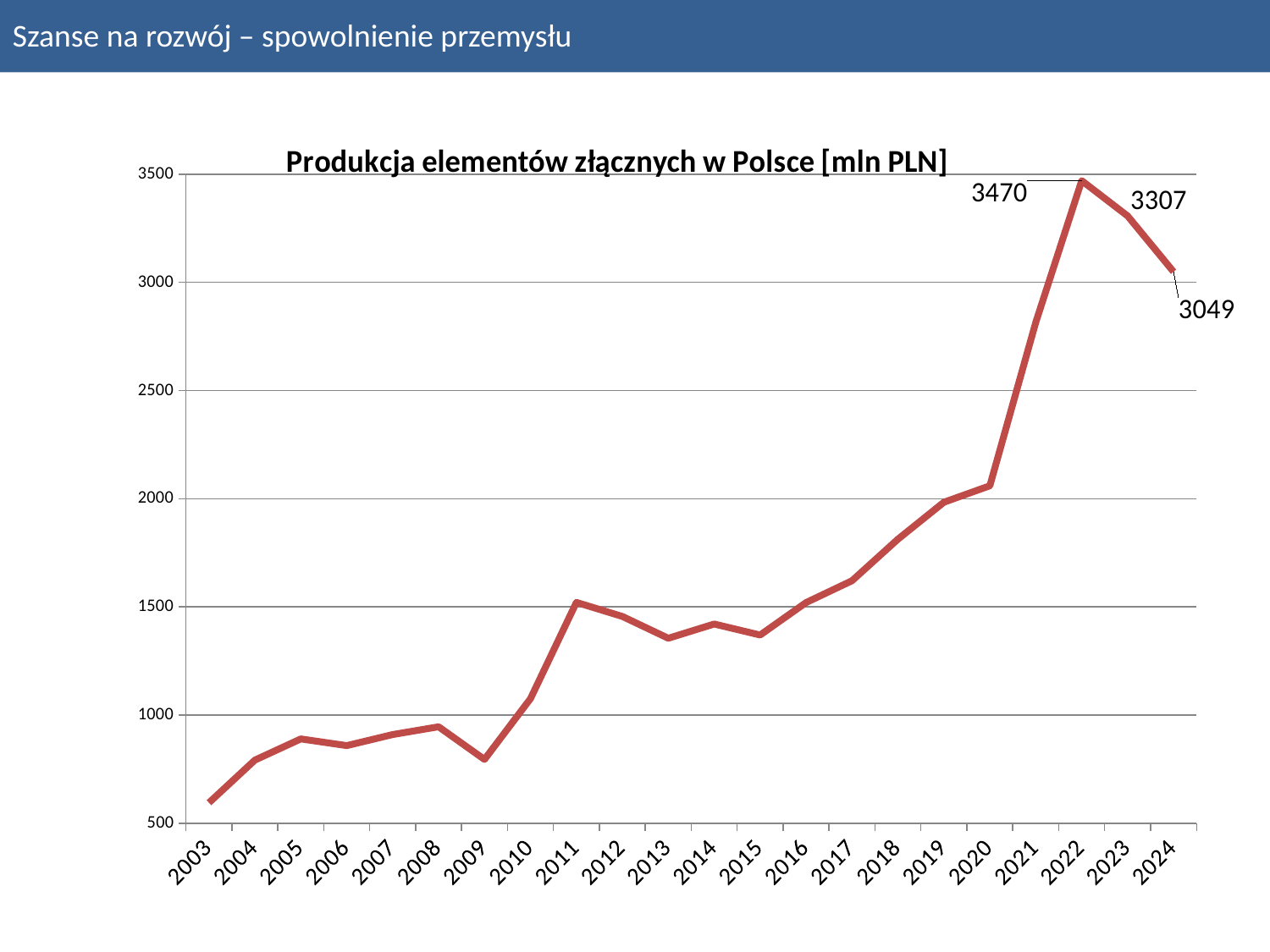
What is the value for 2023? 3307 Which year has the highest value? 2022 Which is larger, the value for 2023 or the value for 2024? 2023 What is the difference between the values for 2022 and 2023? 163 Is the value for 2009 greater or less than 1000? less What is the value for 2022? 3470 How many years are plotted on the x axis? 22 What is the difference between the values for 2022 and 2024? 421 Which year has the lowest value? 2003 Is the value for 2021 greater or less than 2500? greater What is the value for 2024? 3049 What kind of chart is shown? line chart